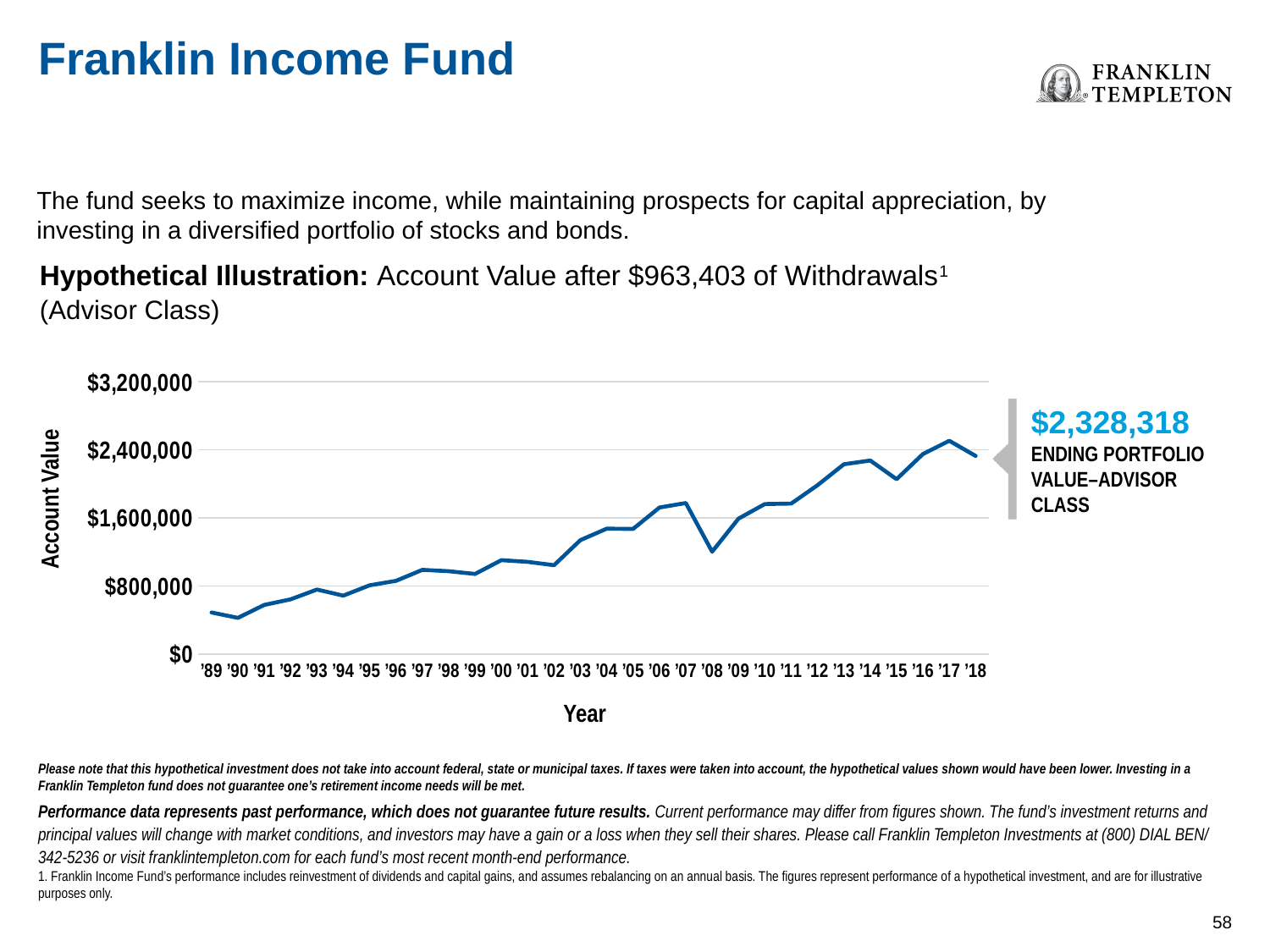
What is the label on the y axis of the chart? Account Value Is the account value for '08 greater or less than $1,600,000? less What kind of chart is shown on the slide? line chart Which year has the highest account value on the chart? '17 Which is larger, the account value for '07 or for '08? '07 Is the account value for '89 greater or less than $800,000? less What is the ending portfolio value for the Advisor Class shown at the end of the line? $2,328,318 Is the account value for '17 greater or less than $2,400,000? greater How many years are plotted along the x axis of the chart? 30 Does the account value generally rise or fall from '89 to '18? rise What is the label on the x axis of the chart? Year